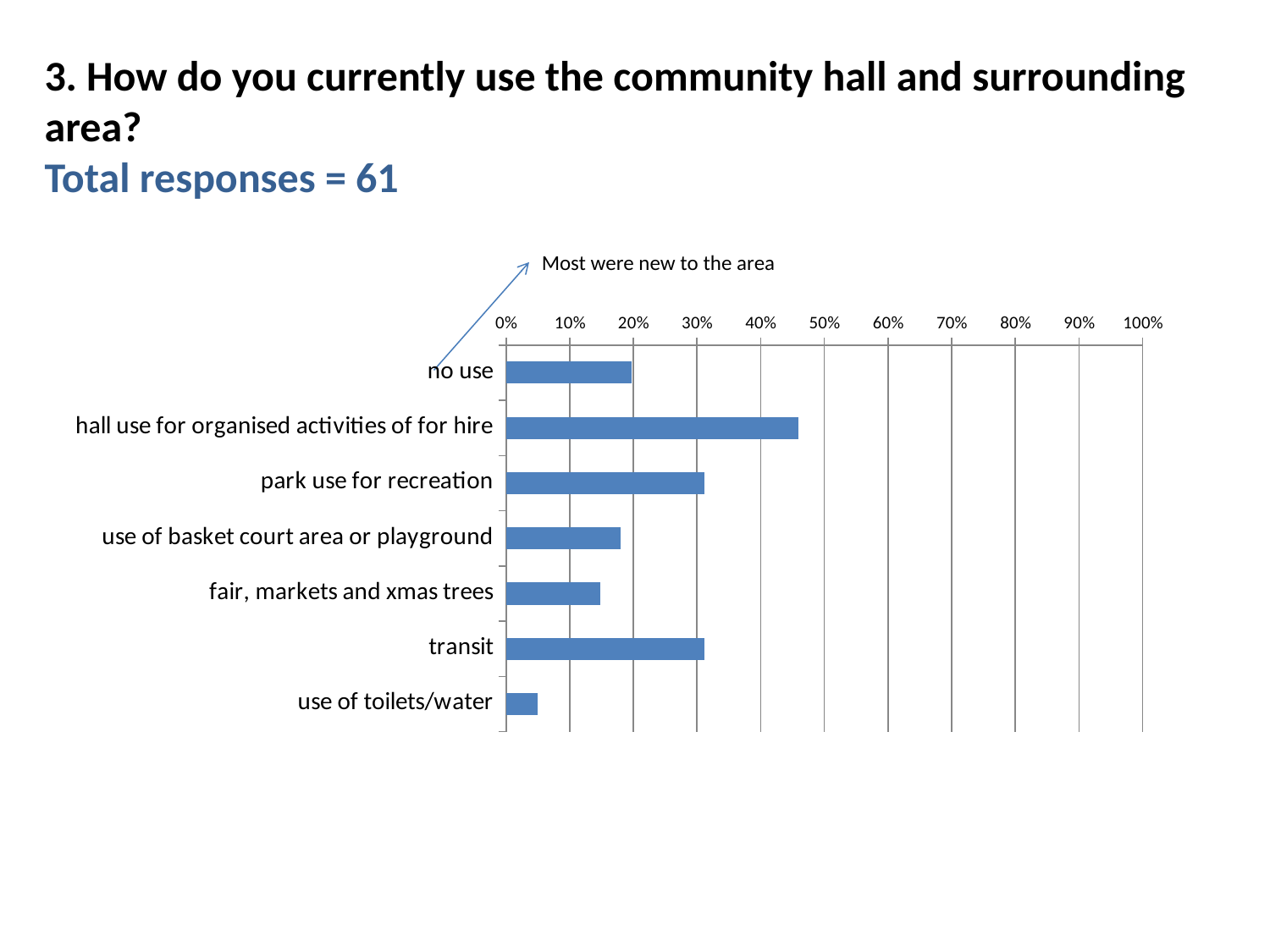
Is the value for 'hall use for organised activities of for hire' greater or less than 40%? greater Is the value for 'transit' greater or less than 20%? greater How many categories are plotted in the chart? 7 Is the value for 'fair, markets and xmas trees' greater or less than 20%? less Which category has the lowest value in the chart? use of toilets/water According to the slide, what is the total number of responses? 61 Which is larger: the value for 'hall use for organised activities of for hire' or the value for 'park use for recreation'? hall use for organised activities of for hire What kind of chart is shown on the slide? bar chart Which category has the highest value in the chart? hall use for organised activities of for hire Which is larger: the value for 'fair, markets and xmas trees' or the value for 'use of toilets/water'? fair, markets and xmas trees